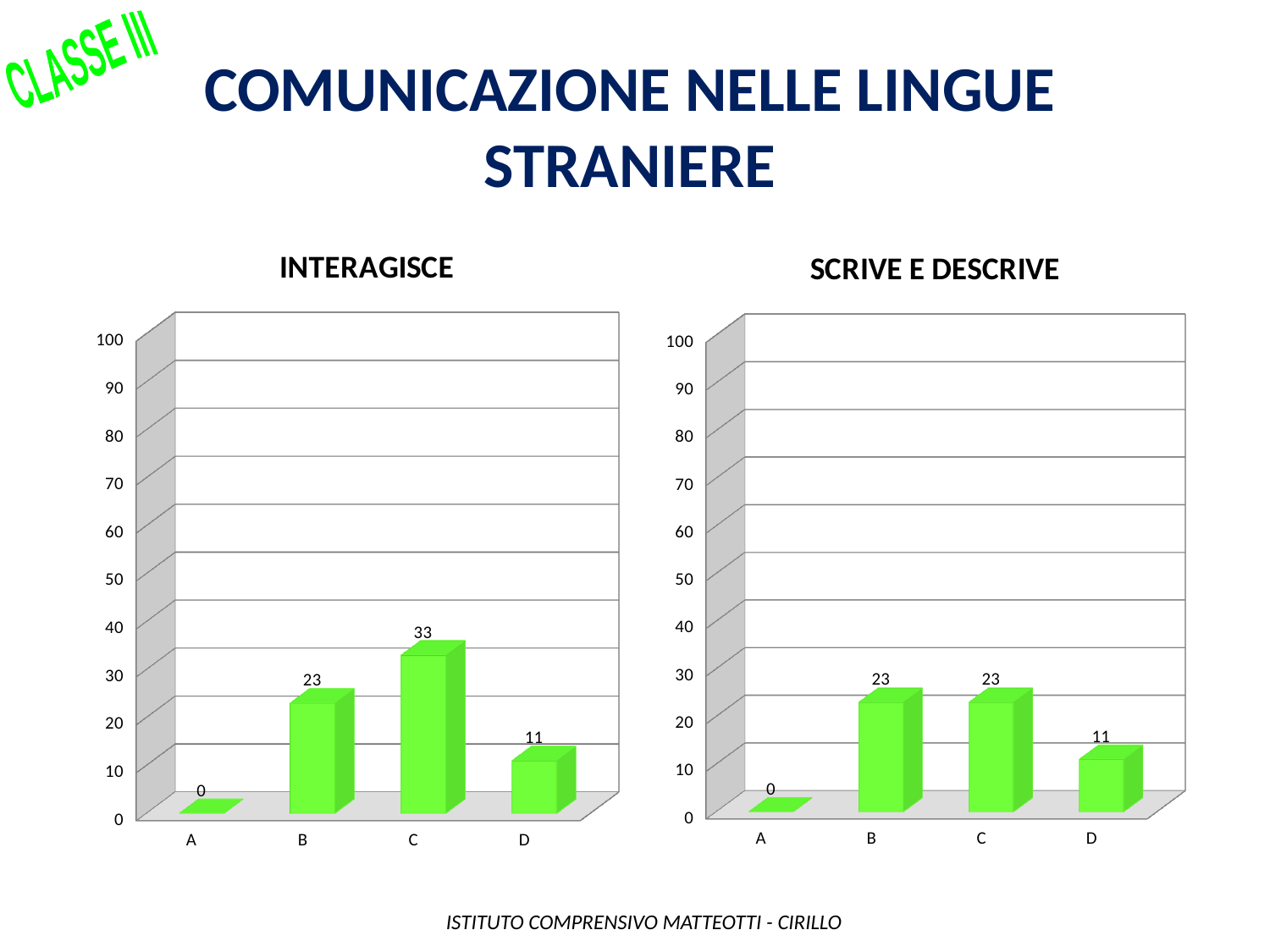
In the SCRIVE E DESCRIVE chart, what is the value for category A? 0 In the INTERAGISCE chart, what is the value for category B? 23 In the INTERAGISCE chart, what is the value for category C? 33 What kind of chart is the INTERAGISCE chart? Bar chart How many categories are shown in the SCRIVE E DESCRIVE chart? 4 In the INTERAGISCE chart, what is the difference between the values for C and D? 22 In the SCRIVE E DESCRIVE chart, which category has the lowest value? A In the INTERAGISCE chart, which is larger, the value for B or the value for D? B In the SCRIVE E DESCRIVE chart, what is the difference between the values for B and D? 12 In the INTERAGISCE chart, which category has the lowest value? A In the SCRIVE E DESCRIVE chart, what is the value for category D? 11 In the INTERAGISCE chart, which category has the highest value? C